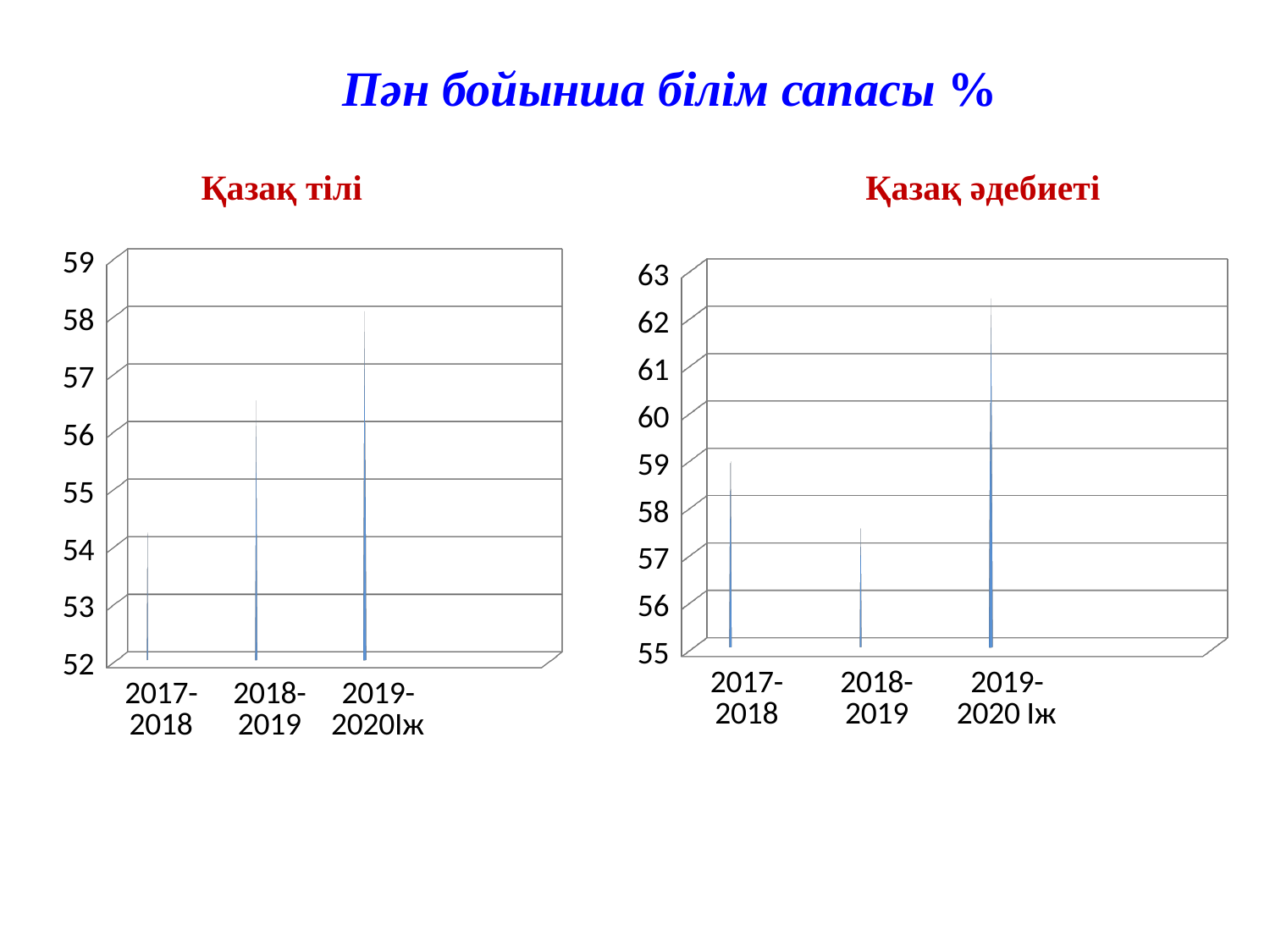
Do the values in the "Қазақ тілі" chart rise or fall from 2017-2018 to 2019-2020Іж? rise In the "Қазақ әдебиеті" chart, is the value for 2019-2020 Іж greater or less than 61? greater How many categories are shown on the x axis of the "Қазақ әдебиеті" chart? 3 In the "Қазақ әдебиеті" chart, which is larger, the value for 2017-2018 or the value for 2018-2019? 2017-2018 In the "Қазақ тілі" chart, is the value for 2017-2018 greater or less than 55? less What is the title of the chart on the right side of the slide? Қазақ әдебиеті In the "Қазақ әдебиеті" chart, which category has the lowest value? 2018-2019 In the "Қазақ тілі" chart, which category has the lowest value? 2017-2018 In the "Қазақ әдебиеті" chart, which category has the highest value? 2019-2020 Іж What kind of chart is the "Қазақ тілі" chart? bar chart In the "Қазақ тілі" chart, which category has the highest value? 2019-2020Іж In the "Қазақ тілі" chart, which is larger, the value for 2018-2019 or the value for 2019-2020Іж? 2019-2020Іж